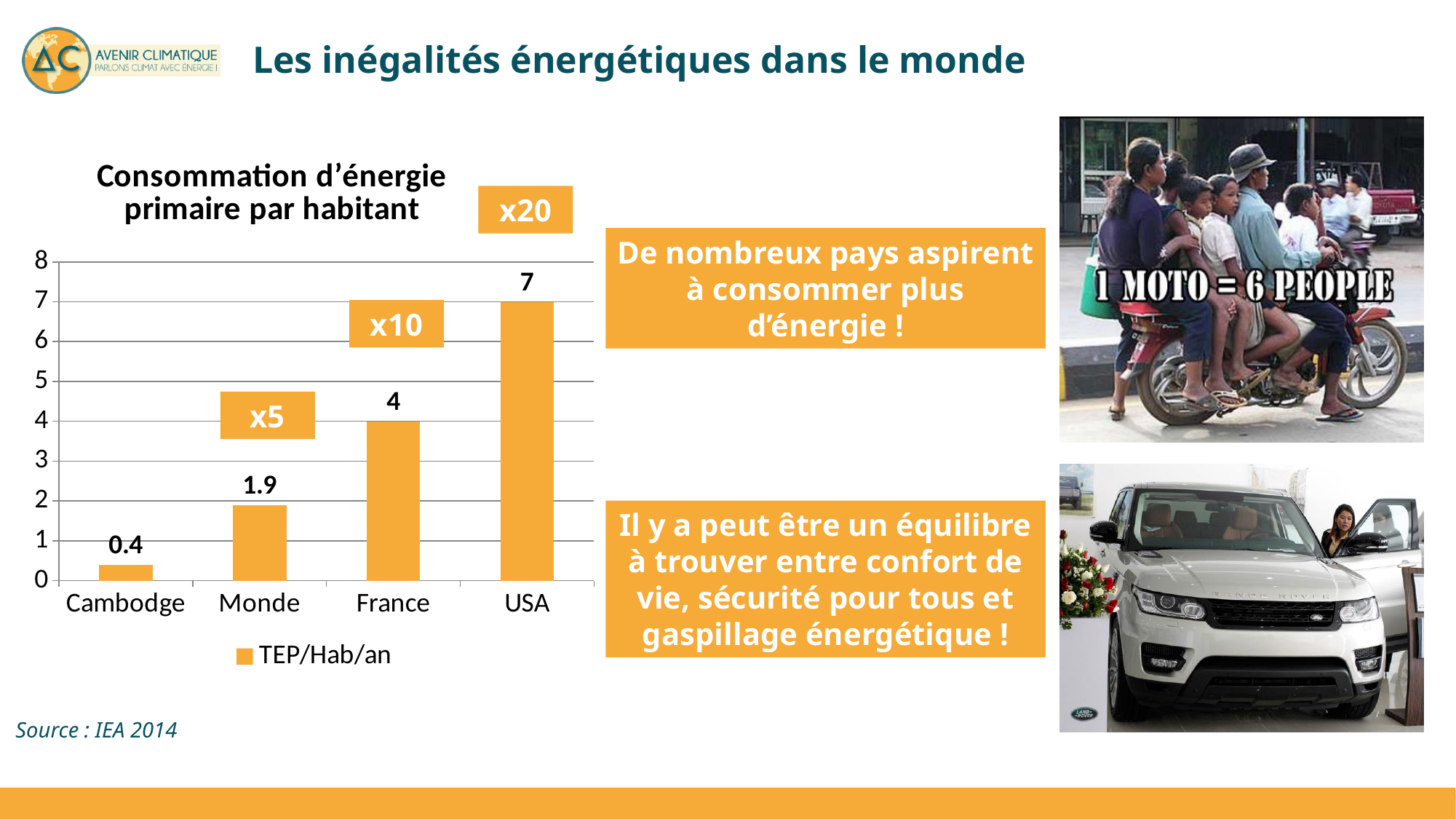
Which category has the highest value? USA How many categories are shown on the x axis? 4 What series name does the legend show? TEP/Hab/an What is the value for Monde? 1.9 What is the difference between the values for Monde and Cambodge? 1.5 What is the difference between the values for USA and France? 3 What kind of chart is shown? Bar chart Which category has the lowest value? Cambodge Which is larger, the value for France or the value for Monde? France What is the value for USA? 7 What is the value for France? 4 What is the value for Cambodge? 0.4